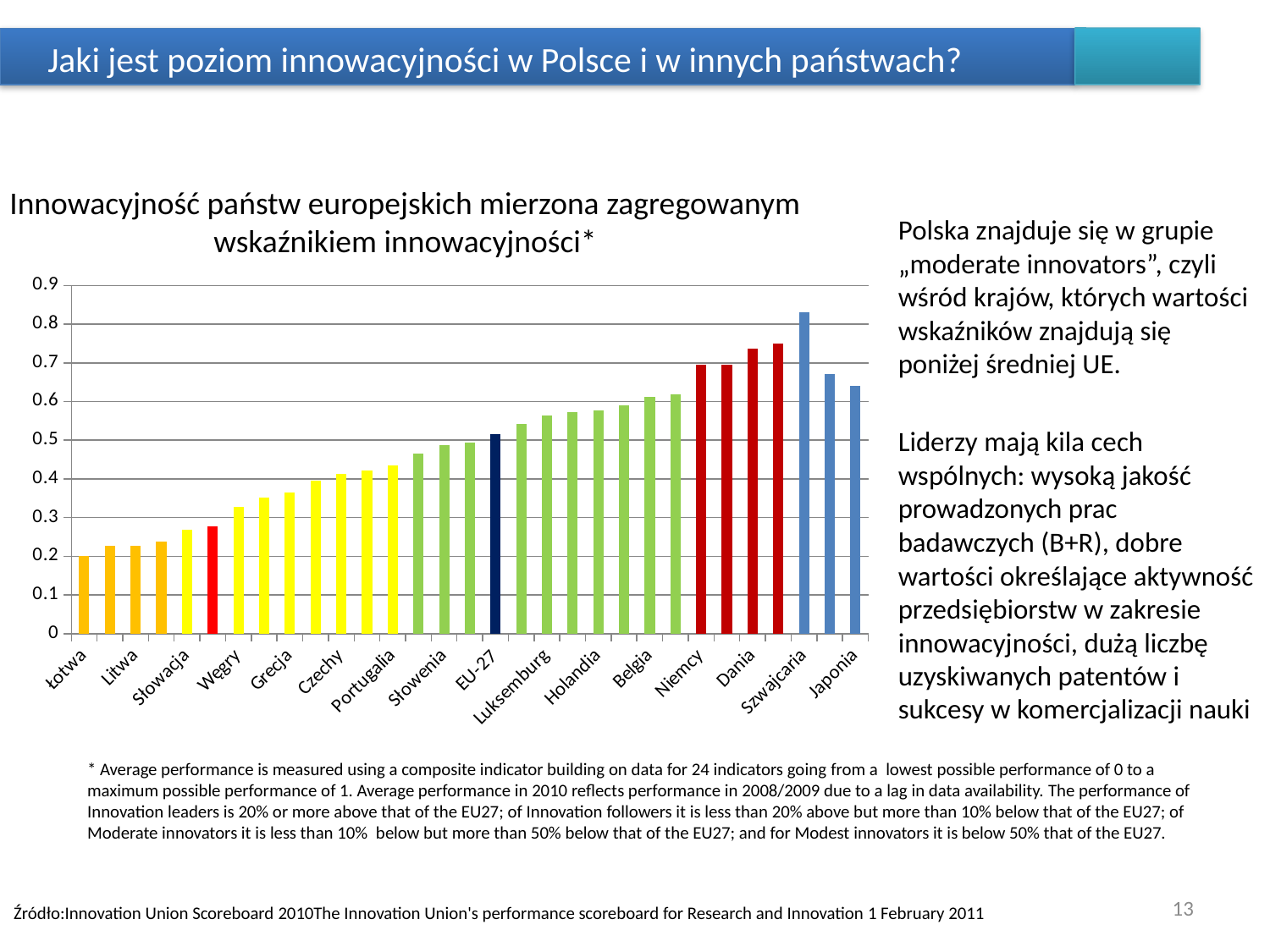
Is the value for Dania greater or less than 0.7? greater What kind of chart is shown on the slide? bar chart Is the value for Szwajcaria greater or less than 0.8? greater Which has a higher value, Szwajcaria or Japonia? Szwajcaria Is the value for Japonia greater or less than 0.7? less Which labelled country has the highest value in the chart? Szwajcaria What is the title of the chart? Innowacyjność państw europejskich mierzona zagregowanym wskaźnikiem innowacyjności* Do the bar values generally rise or fall from Łotwa to Szwajcaria along the x axis? rise Which labelled country has the lowest value in the chart? Łotwa